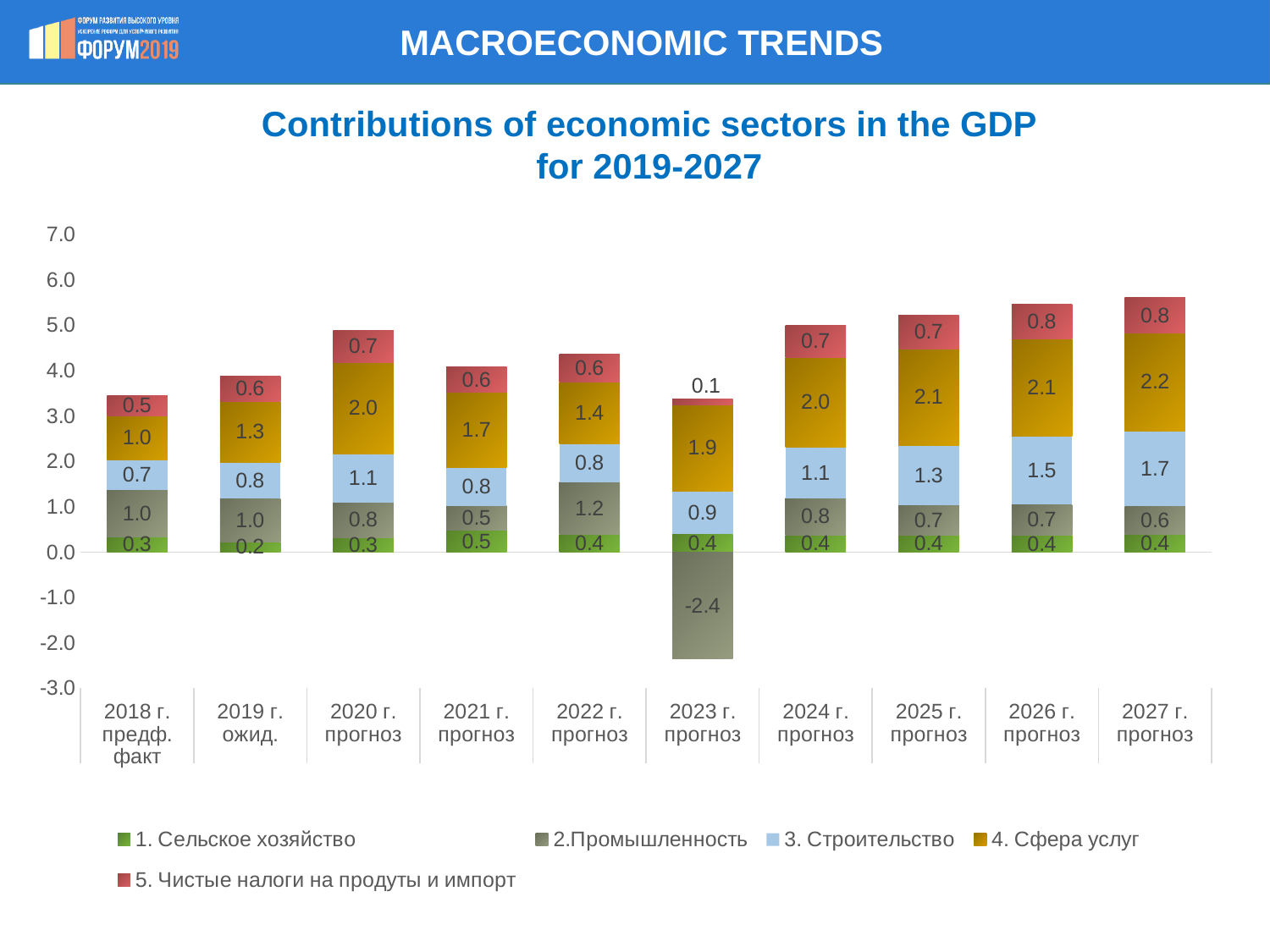
What is the difference between the 4. Сфера услуг values for 2027 г. прогноз and 2018 г. предф. факт? 1.2 What is the value of 3. Строительство for 2018 г. предф. факт? 0.7 What is the total of the stacked bar for 2024 г. прогноз? 5.0 What is the value of 2.Промышленность for 2023 г. прогноз? -2.4 What is the value of 5. Чистые налоги на продуты и импорт for 2023 г. прогноз? 0.1 How many year categories are shown on the x axis? 10 What type of chart is shown on the slide? Stacked bar chart How many series does the legend list? 5 In which year is the value of 1. Сельское хозяйство the lowest? 2019 г. ожид. In which year is the value of 3. Строительство the highest? 2027 г. прогноз What is the value of 4. Сфера услуг for 2027 г. прогноз? 2.2 Which is larger: 2.Промышленность for 2022 г. прогноз or 2.Промышленность for 2020 г. прогноз? 2022 г. прогноз